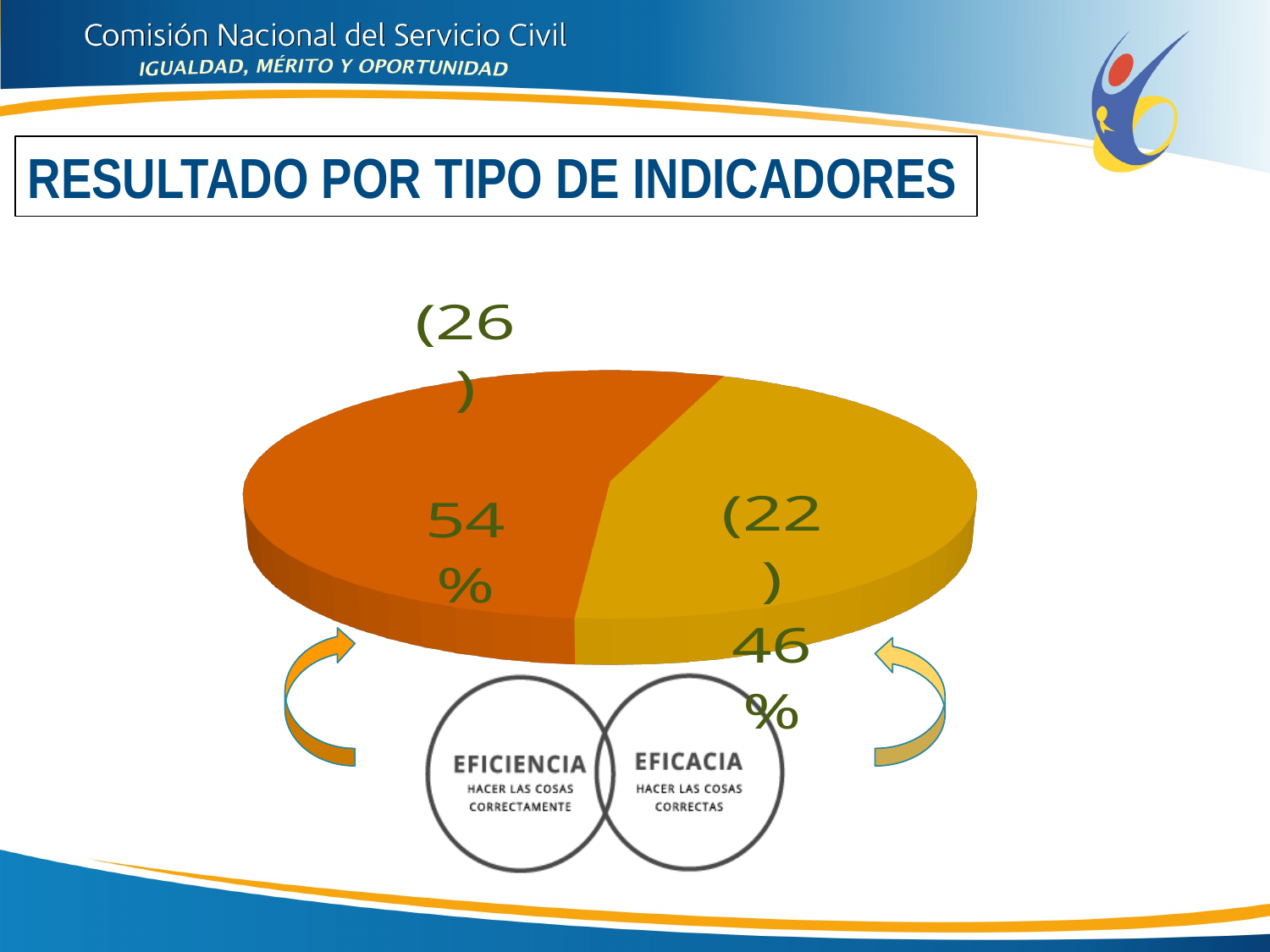
How many slices does the pie chart have? 2 Which is larger, the orange slice or the yellow slice of the pie chart? the orange slice What percentage is shown on the yellow slice of the pie chart? 46% What is the total of the counts shown in parentheses on the two slices? 48 Which slice of the pie chart is the smallest? the yellow slice (46%) Which slice of the pie chart is the largest? the orange slice (54%) What count is shown in parentheses for the orange slice of the pie chart? 26 What is the difference in percentage points between the orange slice and the yellow slice? 8 percentage points What percentage is shown on the orange slice of the pie chart? 54% What kind of chart is shown on the slide? pie chart What count is shown in parentheses for the yellow slice of the pie chart? 22 What is the title of the slide containing the pie chart? RESULTADO POR TIPO DE INDICADORES